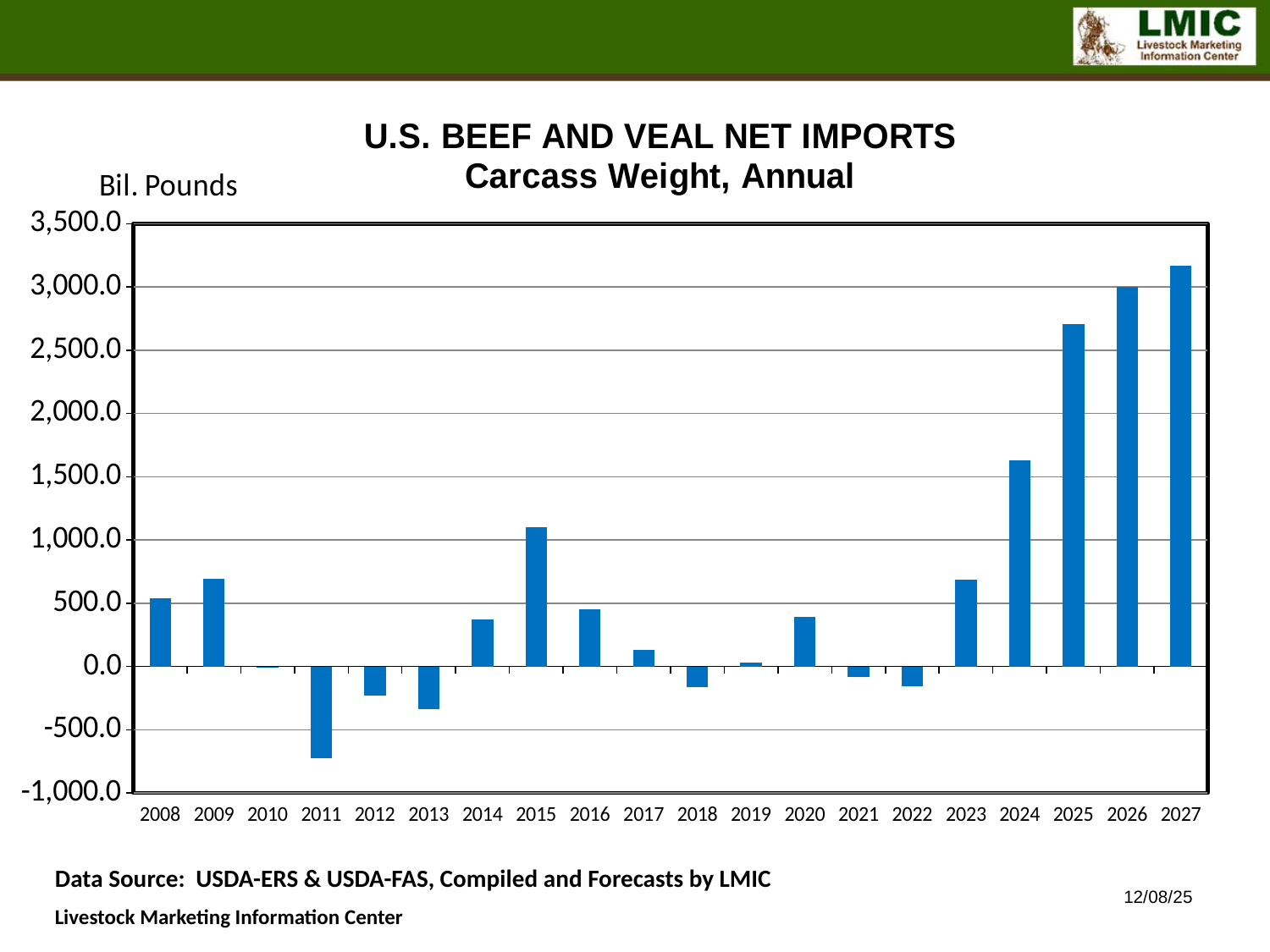
What kind of chart is shown on the slide? Bar chart Is the value for 2013 greater or less than 0.0? less Which year has the larger value, 2008 or 2009? 2009 Is the value for 2024 greater or less than 1,500.0? greater Is the value for 2011 greater or less than -500.0? less What unit is shown on the y axis of the chart? Bil. Pounds Which year has the lowest net imports value? 2011 How many years are plotted along the x axis? 20 Do the values rise or fall from 2023 through 2027? Rise Which year has the highest net imports value? 2027